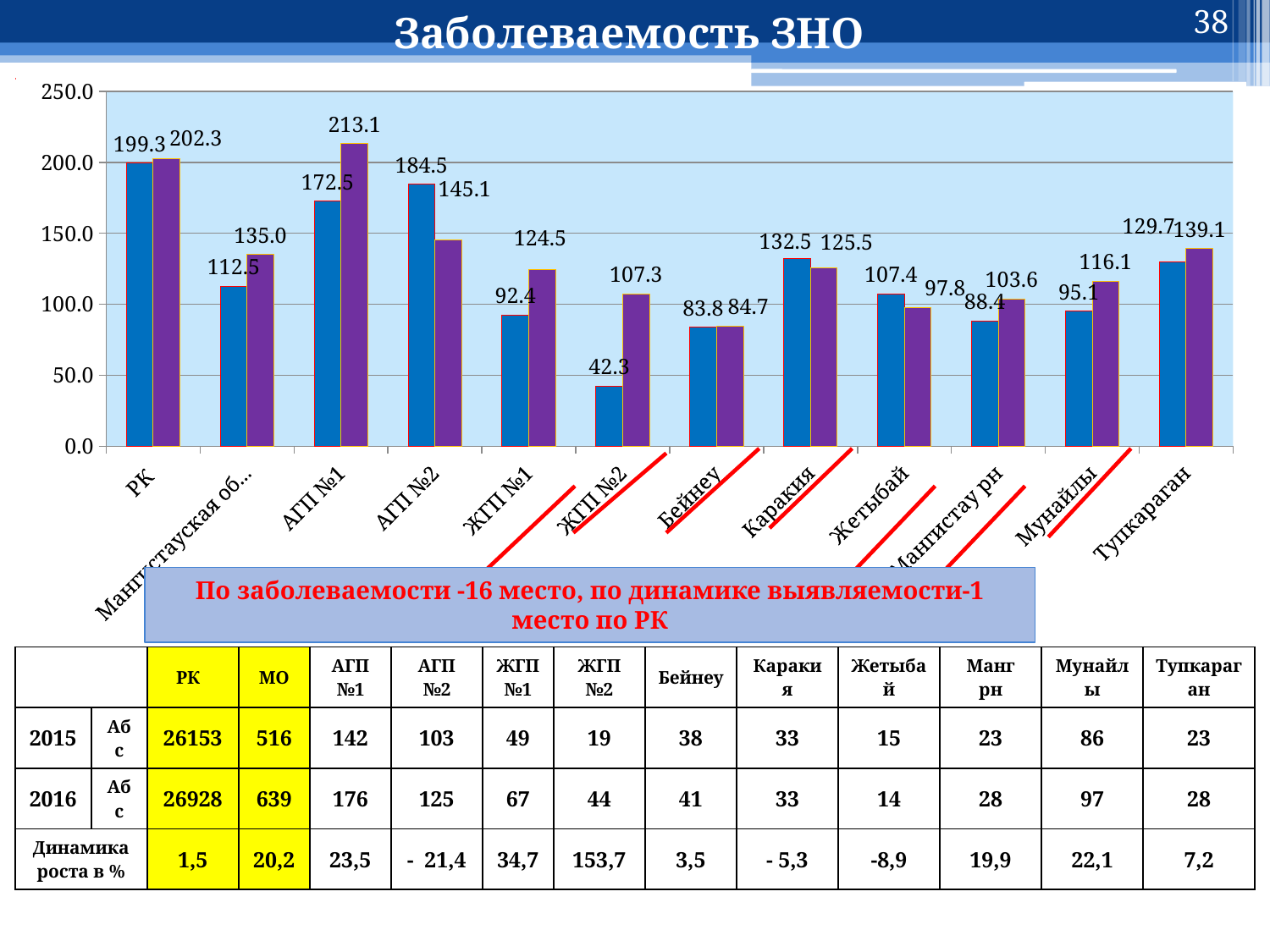
What is the difference between the purple bar and the blue bar for РК? 3.0 What kind of chart is shown on the slide? bar chart What is the difference between the purple bar and the blue bar for ЖГП №2? 65.0 What is the title of the slide containing the chart? Заболеваемость ЗНО Which category has the highest bar in the chart? АГП №1 What is the value of the purple bar for Тупкараган? 139.1 What is the value of the purple bar for АГП №1? 213.1 What is the value of the blue bar for ЖГП №2? 42.3 Is the value of the blue bar for Бейнеу greater or less than 100? less How many categories are shown along the x axis of the chart? 12 For АГП №2, which bar is larger, the blue one or the purple one? blue Which category has the lowest bar in the chart? ЖГП №2